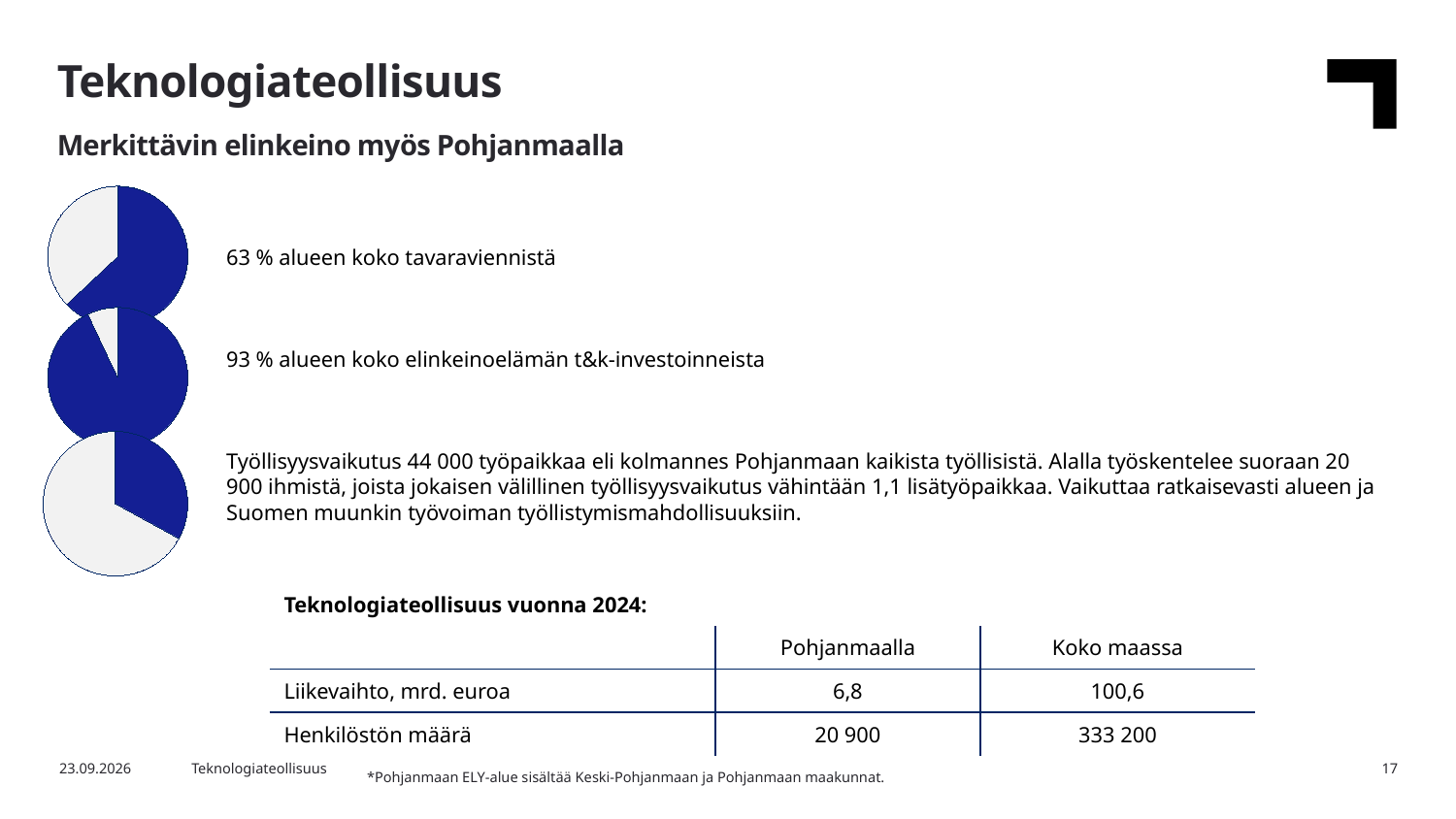
How many slices does the top pie chart have? 2 How many pie charts are on the slide? 3 Which of the three pie charts has the smallest blue slice? The bottom pie chart Is the blue slice larger in the middle pie chart or in the top pie chart? The middle pie chart What colour is used for the highlighted slice in each pie chart? Dark blue Is the blue slice larger in the top pie chart or in the bottom pie chart? The top pie chart In the top pie chart, what share of the region's total goods exports does the blue slice represent? 63 % Which of the three pie charts has the largest blue slice? The middle pie chart In the bottom pie chart, is the blue slice greater or less than 50 % of the pie? less In the middle pie chart, is the blue slice greater or less than 75 % of the pie? greater What kind of charts are shown on the left side of the slide? Pie charts In the middle pie chart, what share of the region's business R&D investments does the blue slice represent? 93 %